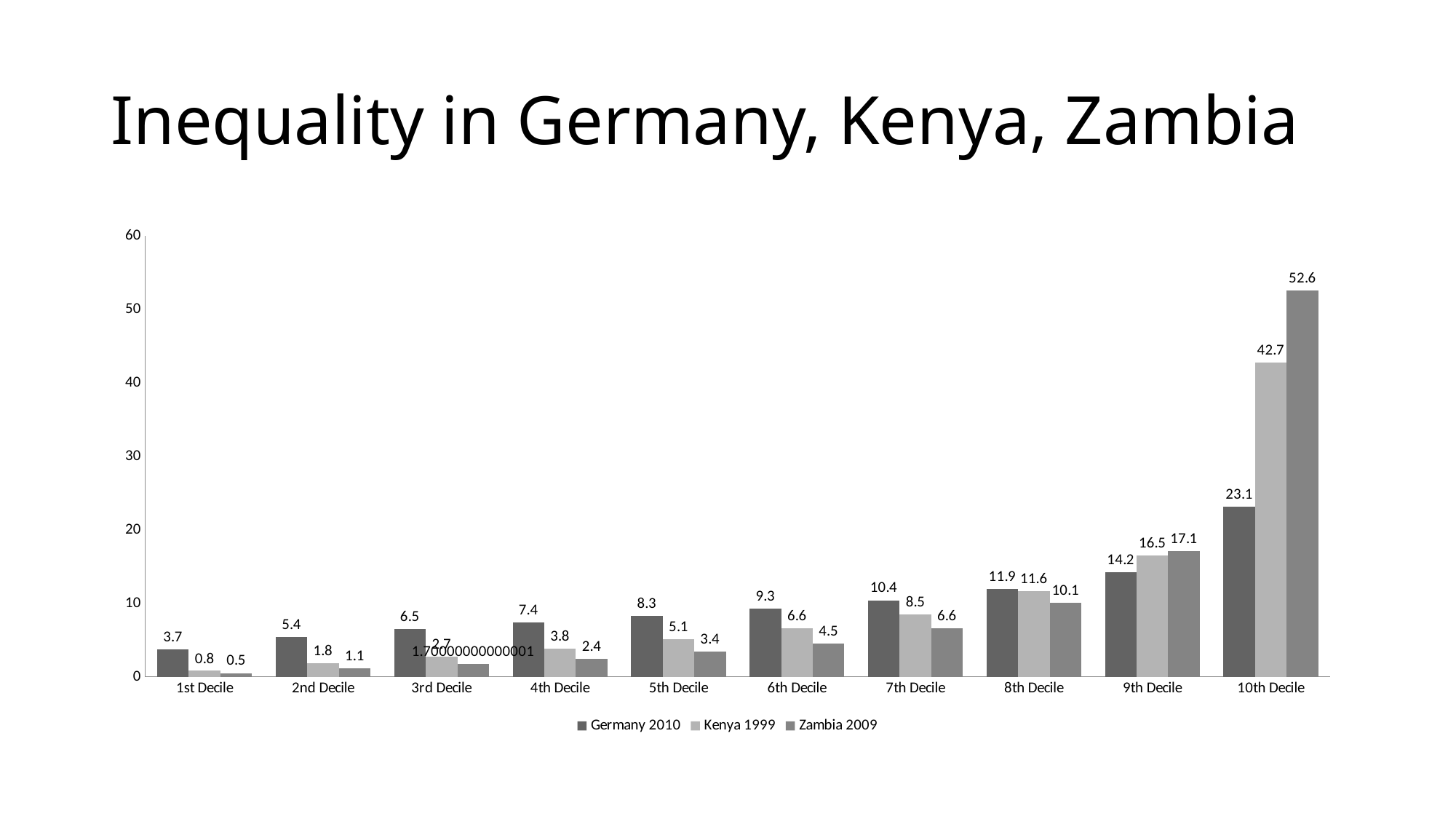
In the 5th Decile, which is larger: the Germany 2010 value or the Kenya 1999 value? Germany 2010 Which series has the lowest value in the 1st Decile? Zambia 2009 How many series does the legend list? 3 Do the Germany 2010 values rise or fall from the 1st Decile to the 10th Decile? rise What is the value for Kenya 1999 in the 7th Decile? 8.5 How many decile categories are shown on the x axis? 10 Is the value for Zambia 2009 in the 10th Decile greater or less than 50? greater What is the value for Zambia 2009 in the 10th Decile? 52.6 What kind of chart is shown on the slide? bar chart What is the value for Germany 2010 in the 1st Decile? 3.7 Which series has the highest value in the 10th Decile? Zambia 2009 What is the difference between the Kenya 1999 and Germany 2010 values in the 10th Decile? 19.6